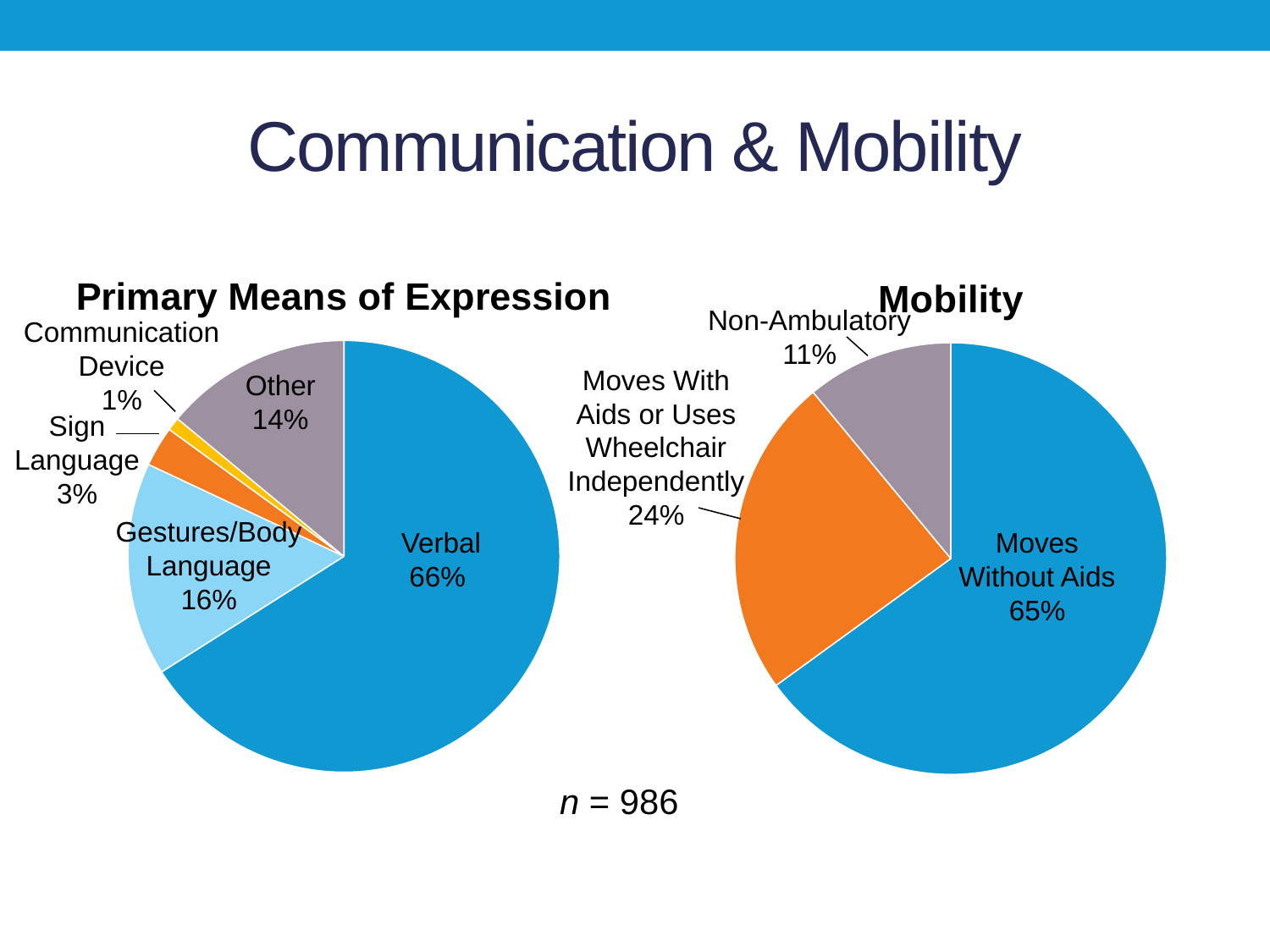
In the Primary Means of Expression pie chart, what share is Verbal? 66% In the Mobility pie chart, what share is Moves With Aids or Uses Wheelchair Independently? 24% In the Primary Means of Expression pie chart, what is the difference between the Other and Sign Language shares? 11% In the Mobility pie chart, how many categories are shown? 3 In the Primary Means of Expression pie chart, how many slices are there? 5 In the Primary Means of Expression pie chart, what share is Communication Device? 1% In the Primary Means of Expression pie chart, which category has the largest share? Verbal In the Primary Means of Expression pie chart, what share is Gestures/Body Language? 16% In the Mobility pie chart, which category has the largest share? Moves Without Aids In the Primary Means of Expression pie chart, which category has the smallest share? Communication Device What type of chart is the Mobility chart? Pie chart In the Mobility pie chart, what share is Non-Ambulatory? 11%